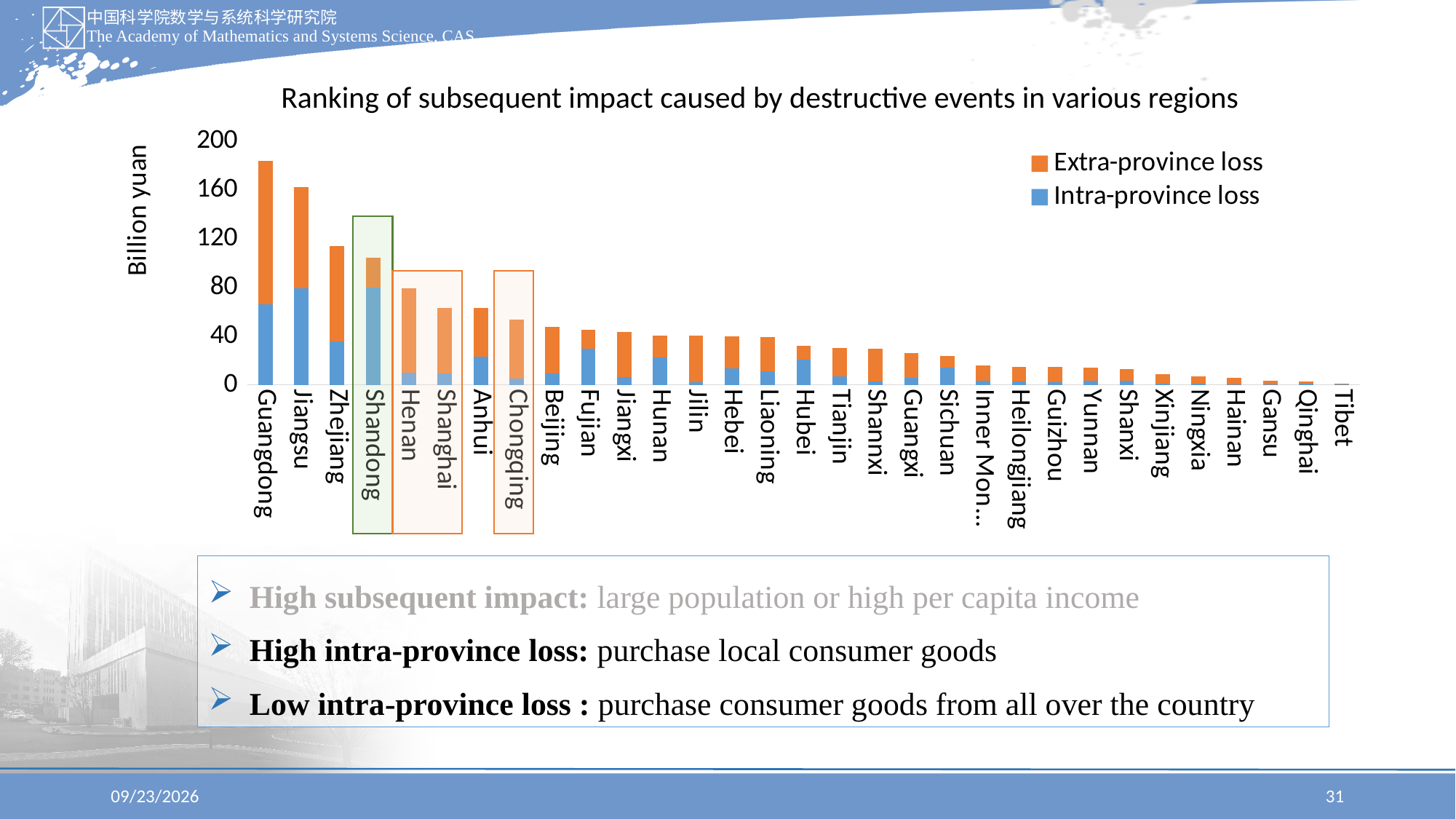
Is the total value for Shandong greater or less than 80? greater What kind of chart is shown on the slide? Stacked bar chart How many series does the legend list? 2 Do the total bar heights rise or fall moving from left to right along the x axis? Fall How many regions are shown along the x axis? 31 Is the total value for Hubei greater or less than 40? less Which region has the lowest total subsequent impact? Tibet Which has a larger intra-province loss, Guangdong or Jiangsu? Jiangsu Is the total value for Zhejiang greater or less than 120? less What is the label on the y axis? Billion yuan Which region has the highest total subsequent impact? Guangdong